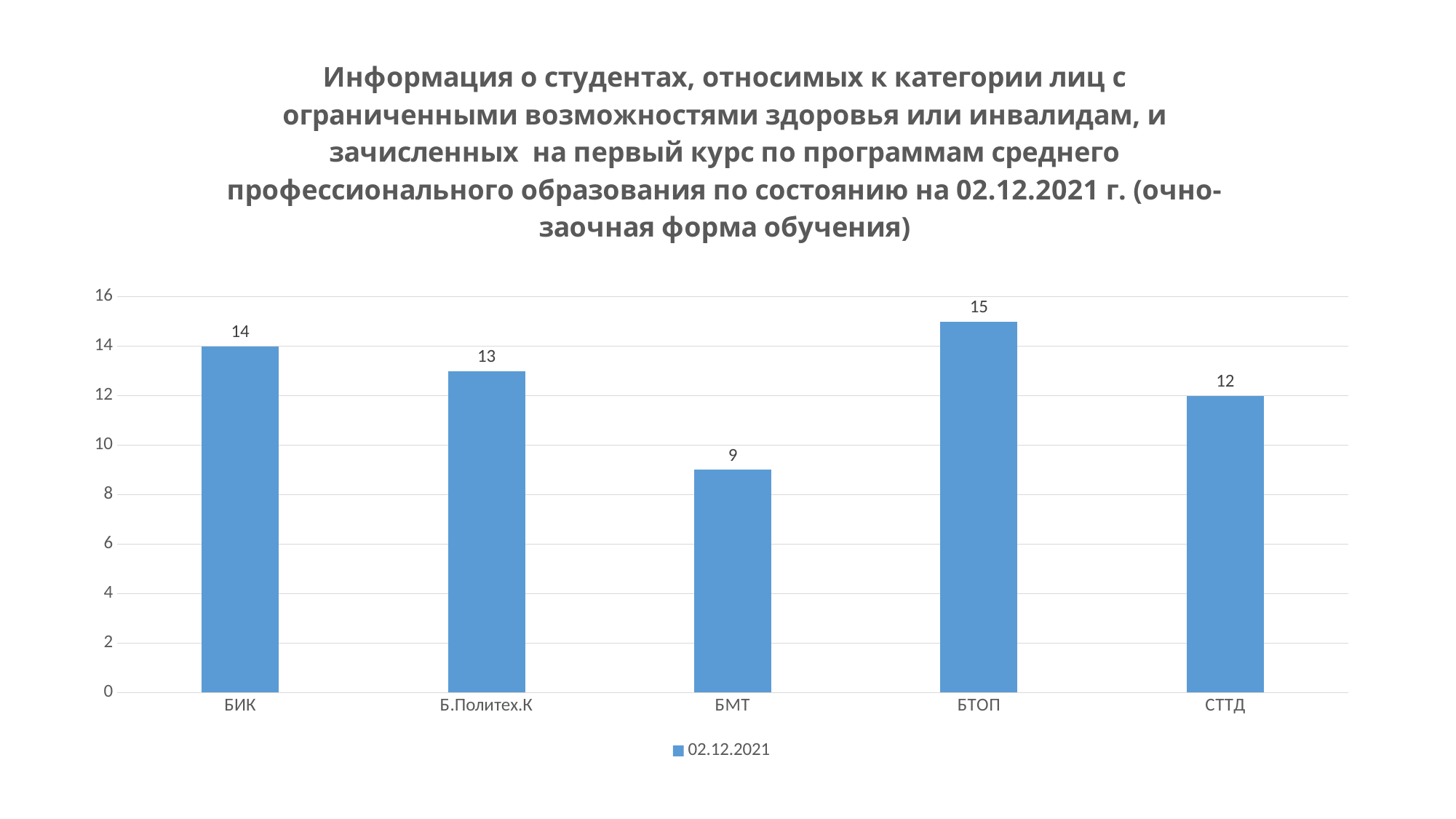
What is the difference between the values for БТОП and БМТ? 6 How many categories are shown on the x axis? 5 What is the value for БМТ? 9 Which is larger, the value for Б.Политех.К or the value for СТТД? Б.Политех.К What is the value for БИК? 14 How many series does the legend list? 1 What kind of chart is shown on the slide? bar chart Is the value for БМТ greater or less than 10? less What is the value for СТТД? 12 What is the legend entry for the series? 02.12.2021 Which category has the highest value? БТОП Which category has the lowest value? БМТ